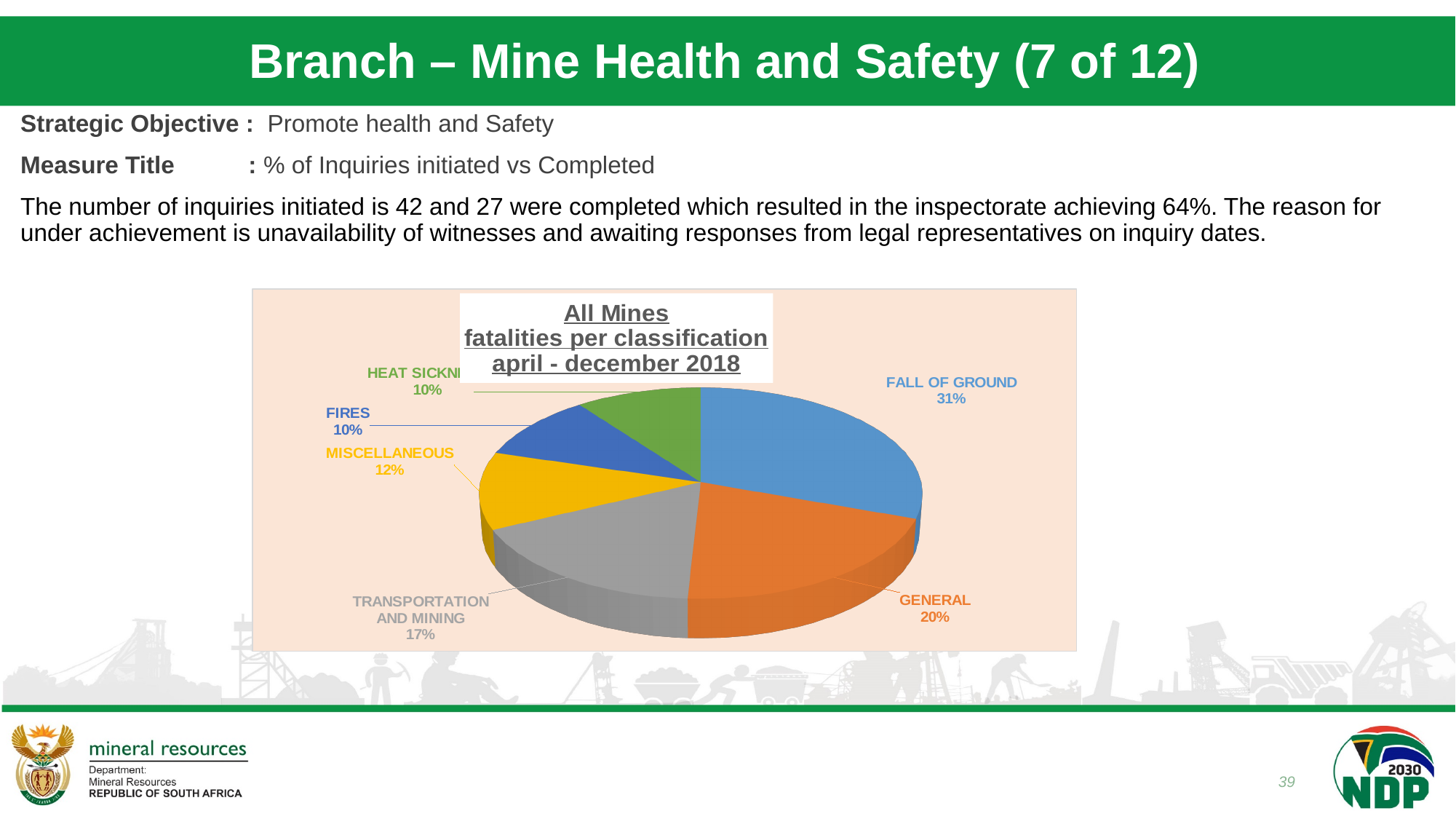
Which has a larger share of fatalities, MISCELLANEOUS or TRANSPORTATION AND MINING? TRANSPORTATION AND MINING What percentage of fatalities is attributed to FALL OF GROUND? 31% How many slices does the pie chart have? 6 What percentage of fatalities is attributed to FIRES? 10% What percentage of fatalities is attributed to TRANSPORTATION AND MINING? 17% What is the difference in percentage points between FALL OF GROUND and GENERAL? 11 percentage points What kind of chart is shown on the slide? Pie chart What is the title of the pie chart? All Mines fatalities per classification april - december 2018 What is the combined share of FALL OF GROUND and GENERAL? 51% What percentage of fatalities is attributed to GENERAL? 20% What percentage of fatalities is attributed to MISCELLANEOUS? 12% Which classification has the largest share of fatalities? FALL OF GROUND